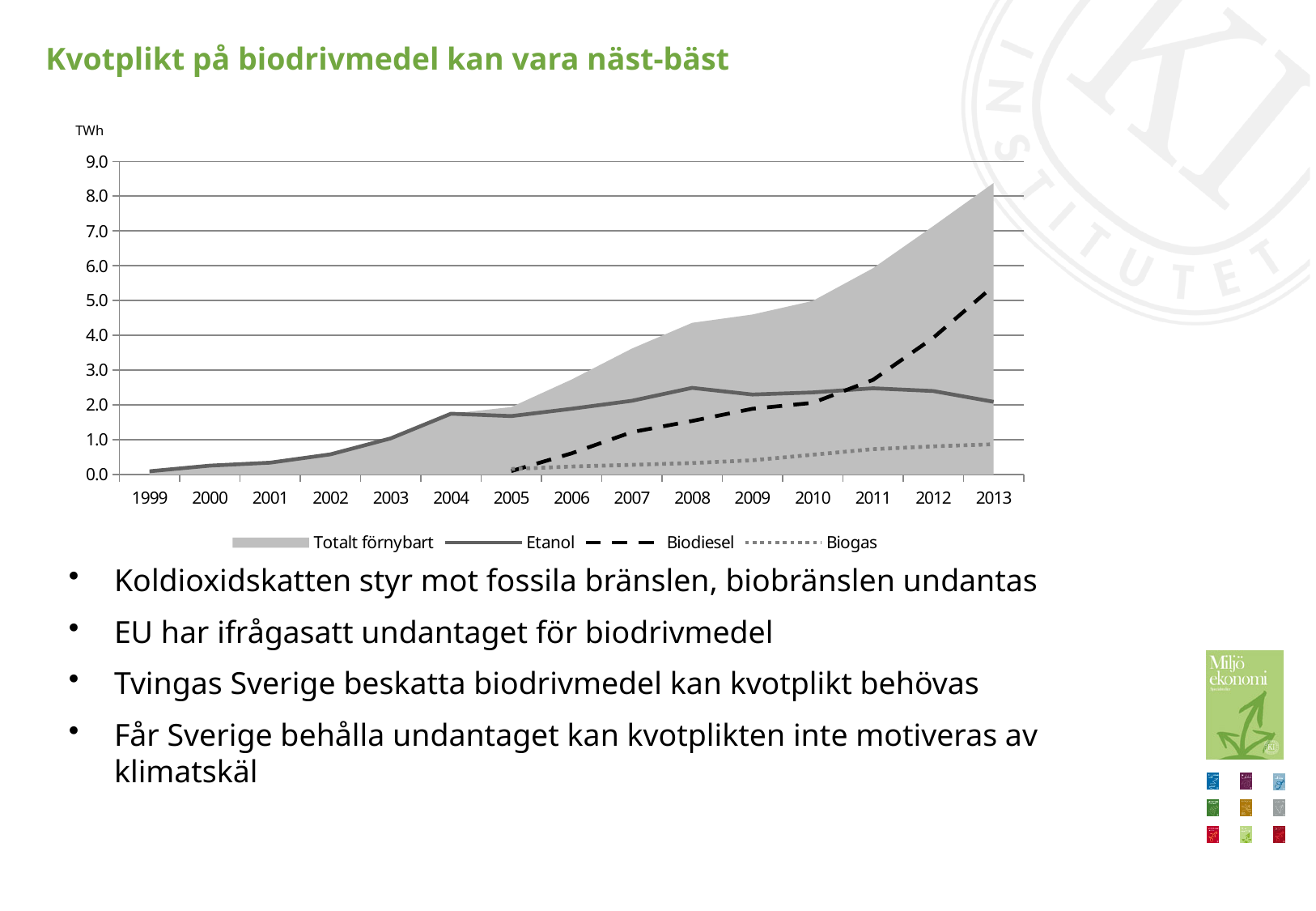
In 2013, which is larger, Biodiesel or Etanol? Biodiesel How many years are shown on the x axis of the chart? 15 Is the value for Biodiesel in 2013 greater or less than 4.0? greater Is the value for Totalt förnybart in 2013 greater or less than 8.0? greater How many series does the chart legend list? 4 Which series in the legend is drawn as a dashed line? Biodiesel Does Totalt förnybart rise or fall from 1999 to 2013? rise Is the value for Totalt förnybart in 2004 greater or less than 3.0? less What unit is shown on the y axis of the chart? TWh In 2008, which is larger, Etanol or Biodiesel? Etanol